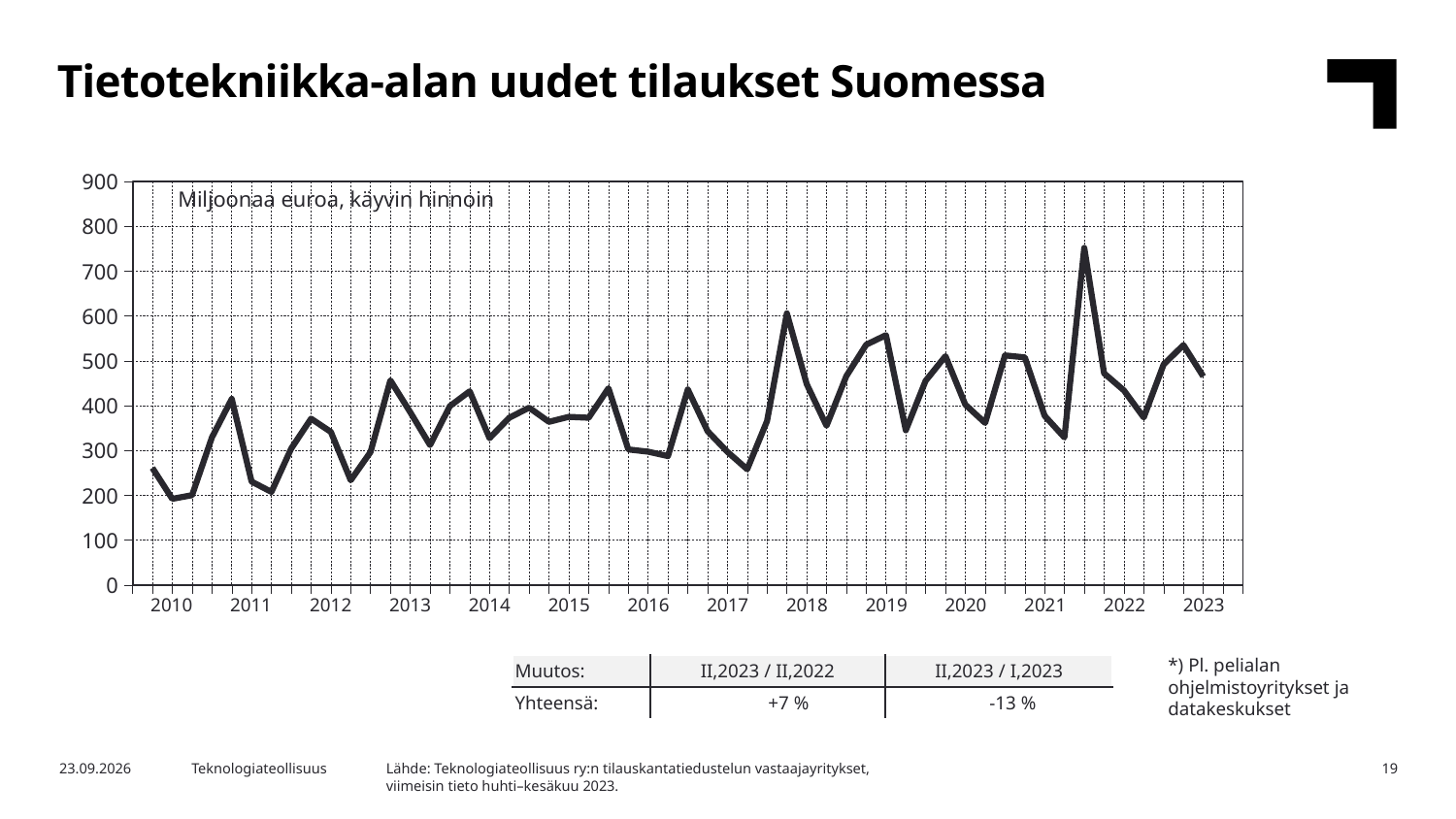
How many year labels are shown on the x axis? 14 Overall, does the line rise or fall from 2010 to 2023? rise Is the lowest value of the line, in 2010, greater or less than 250? less Is the last plotted value in 2023 greater or less than 400? greater Is the highest peak of the line, in 2021, greater or less than 700? greater In which year does the line reach its highest point? 2021 What unit is stated in the label inside the chart area? Miljoonaa euroa, käyvin hinnoin How many lines are plotted in the chart? 1 According to the table below the chart, what is the change (Muutos) for II,2023 / II,2022? +7 % What is the title of the slide's chart? Tietotekniikka-alan uudet tilaukset Suomessa What kind of chart is shown on the slide? line chart